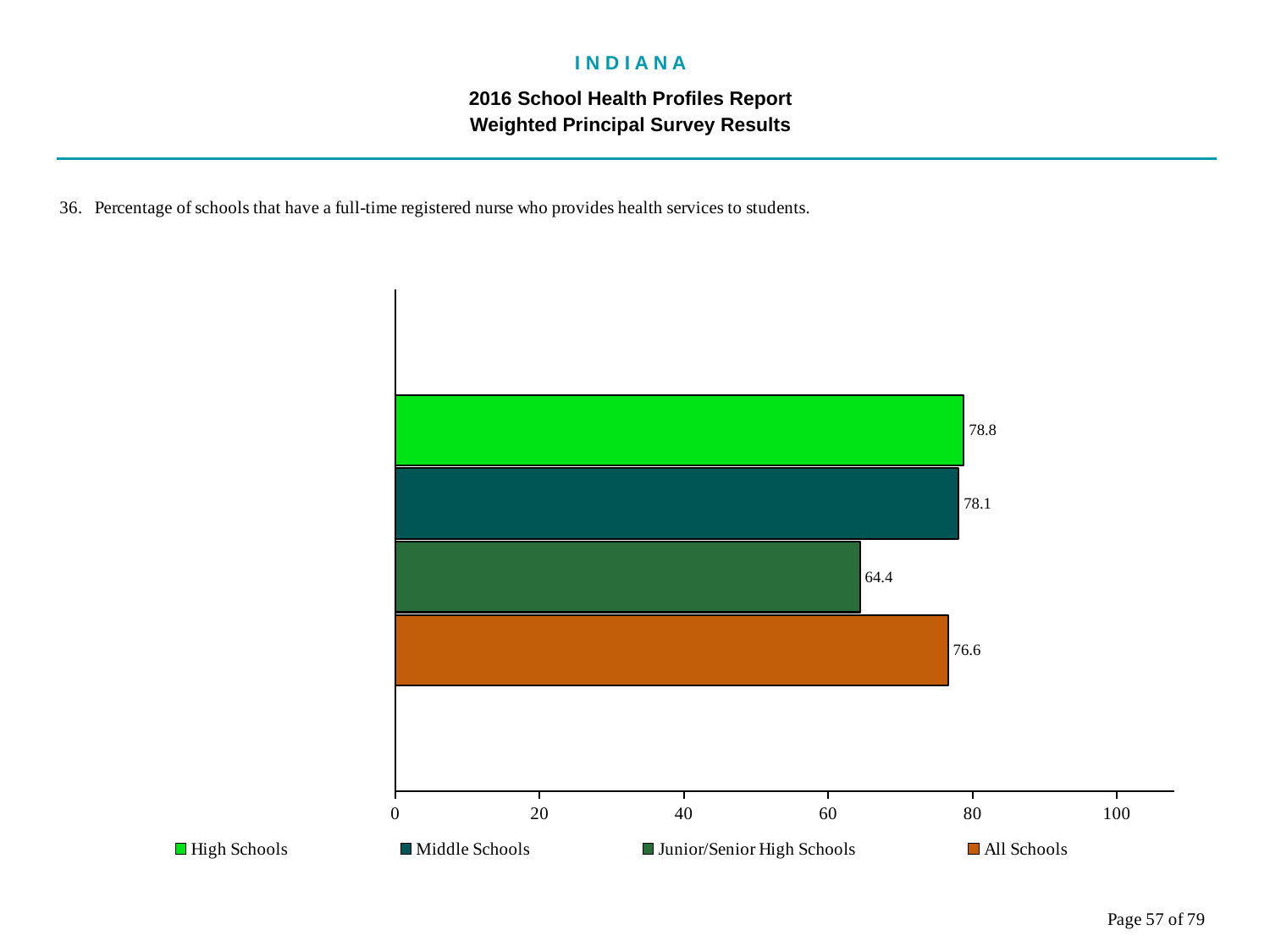
How many bars are shown in the chart? 4 Which category has the lowest value? Junior/Senior High Schools Is the value for Junior/Senior High Schools greater or less than 80? less What is the value for All Schools? 76.6 Which is larger, the value for All Schools or the value for Junior/Senior High Schools? All Schools What is the value for Junior/Senior High Schools? 64.4 What is the value for High Schools? 78.8 What kind of chart is shown on the slide? bar chart What is the difference between the values for High Schools and Junior/Senior High Schools? 14.4 What is the value for Middle Schools? 78.1 How many entries does the legend list? 4 What is the difference between the values for Middle Schools and All Schools? 1.5